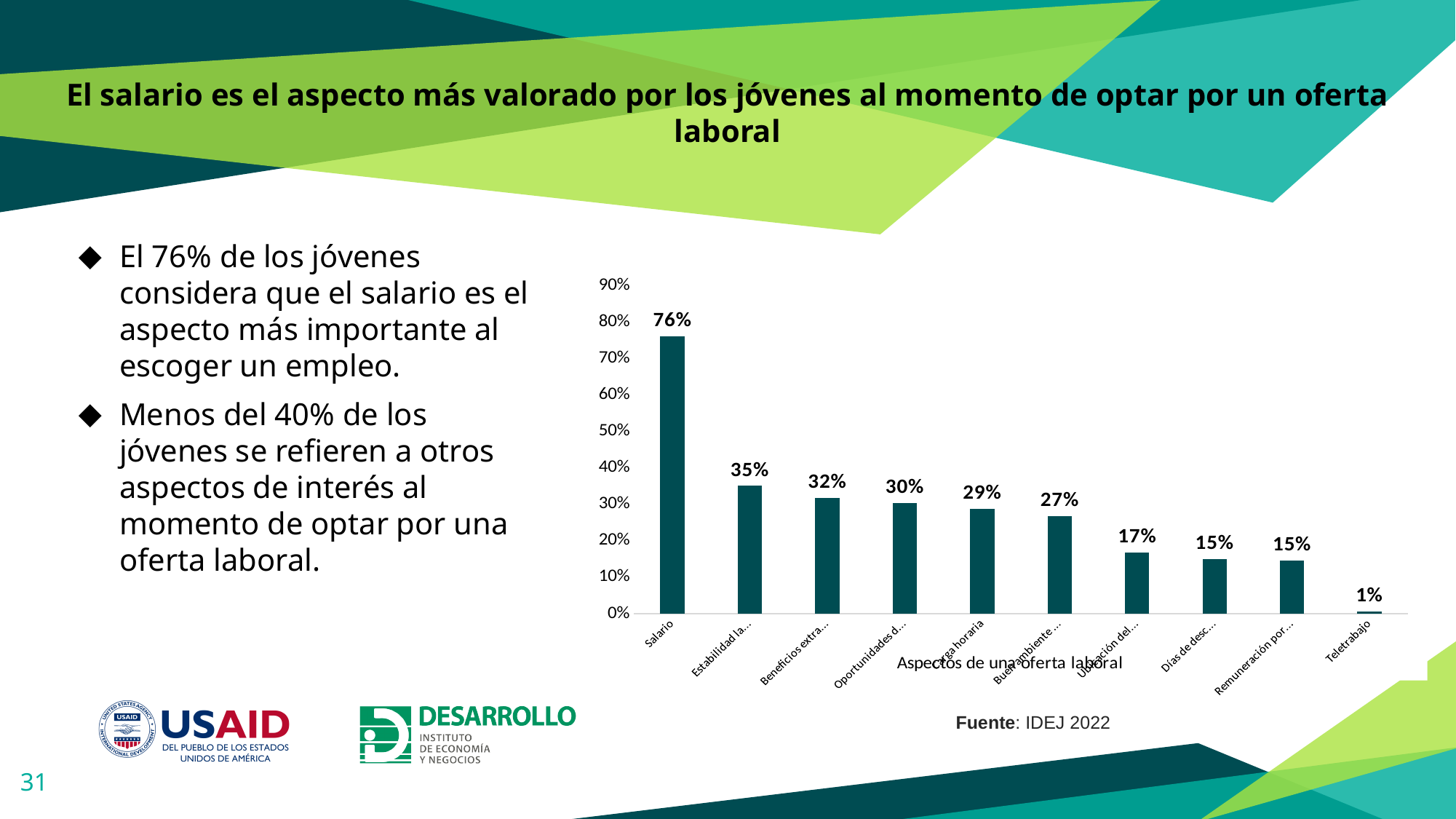
What is the value for Salario? 76% Which category has the lowest value? Teletrabajo What kind of chart is shown on the slide? Bar chart What is the title of the horizontal axis of the chart? Aspectos de una oferta laboral Which is larger, the value for Salario or the value for Carga horaria? Salario What is the value for Teletrabajo? 1% What is the difference between the value for Salario and the value for Carga horaria? 47% What is the value of the third bar from the left (Beneficios extra...)? 32% What is the value for Carga horaria? 29% Is the value for Salario greater or less than 70%? greater Which category has the highest value? Salario How many categories (bars) are shown in the chart? 10